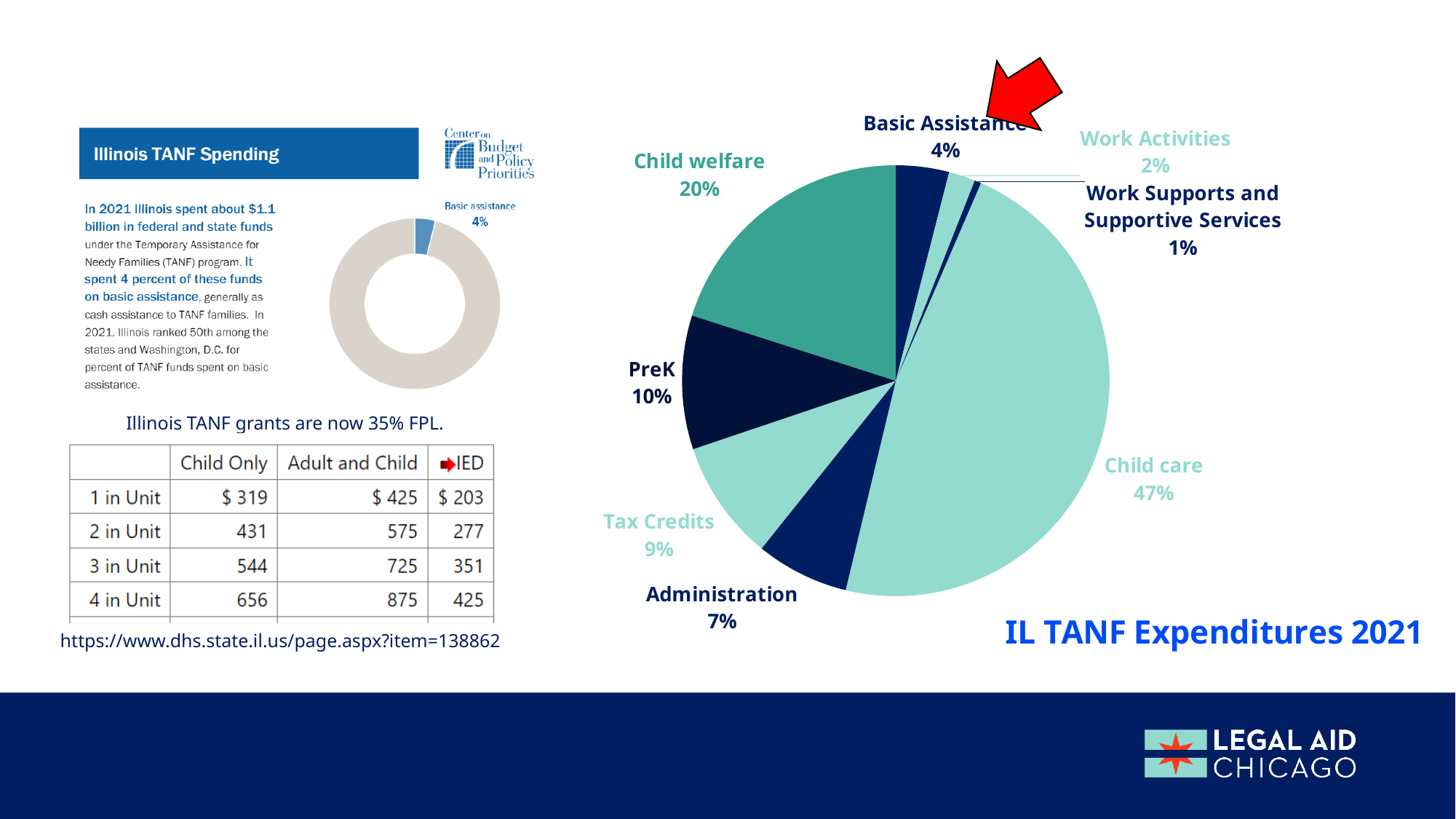
What is the title of the pie chart on the right side of the slide? IL TANF Expenditures 2021 How many slices does the IL TANF Expenditures 2021 pie chart have? 8 In the IL TANF Expenditures 2021 pie chart, which category has the smallest share? Work Supports and Supportive Services In the IL TANF Expenditures 2021 pie chart, how many percentage points larger is Child welfare than PreK? 10 In the IL TANF Expenditures 2021 pie chart, what is the combined share of Child care and Child welfare? 67% In the IL TANF Expenditures 2021 pie chart, what percentage is labelled for Basic Assistance? 4% In the IL TANF Expenditures 2021 pie chart, which category has the largest share? Child care In the IL TANF Expenditures 2021 pie chart, what is the share for Child welfare? 20% What kind of chart is the IL TANF Expenditures 2021 chart? Pie chart In the IL TANF Expenditures 2021 pie chart, what share of expenditures goes to Child care? 47% In the IL TANF Expenditures 2021 pie chart, which is larger: Tax Credits or Administration? Tax Credits In the small donut chart in the Illinois TANF Spending box, what percentage is labelled for Basic assistance? 4%